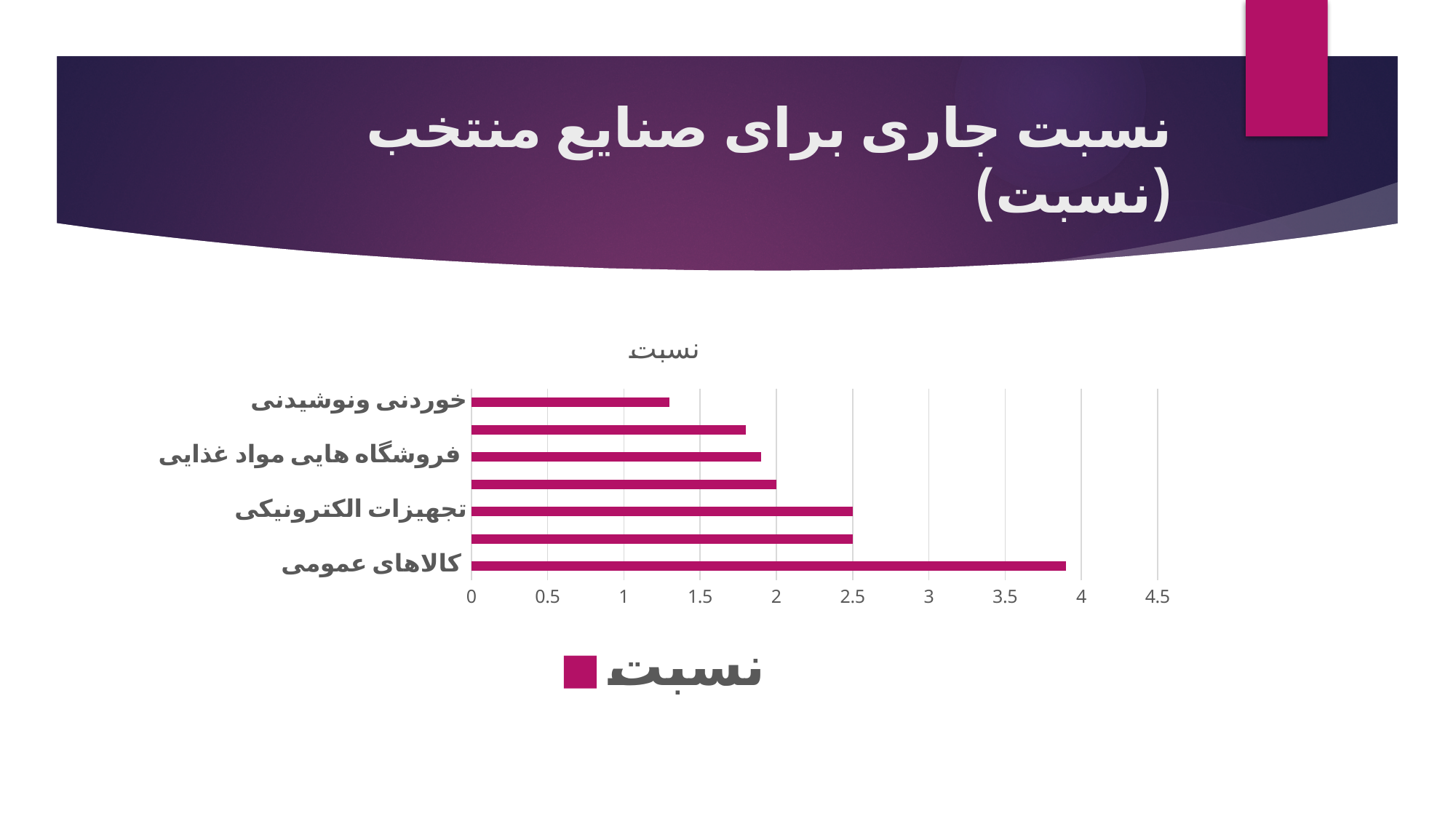
Is the value for خوردنی ونوشیدنی greater or less than 1.5? less How many bars are plotted in the chart? 7 Is the value for خوردنی ونوشیدنی greater or less than 1? greater Is the value for فروشگاه هایی مواد غذایی greater or less than 2? less What is the value for تجهیزات الکترونیکی? 2.5 What kind of chart is shown on the slide? Bar chart How many series does the legend list? 1 Which category has the lowest value in the chart? خوردنی ونوشیدنی Which is larger, the value for کالاهای عمومی or the value for خوردنی ونوشیدنی? کالاهای عمومی What is the name of the series shown in the legend? نسبت Which category has the highest value in the chart? کالاهای عمومی